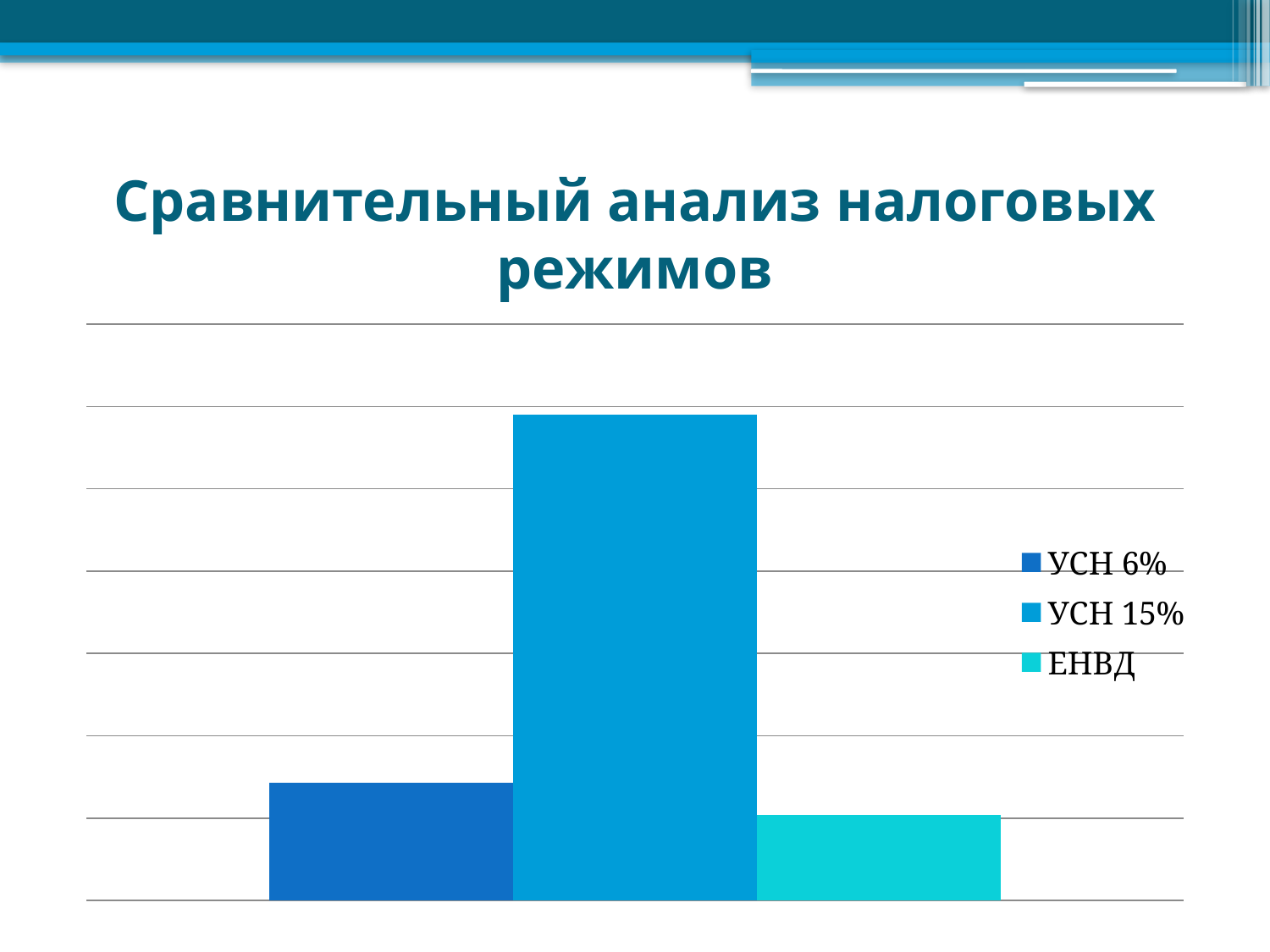
What kind of chart is shown on the slide? bar chart What are the three entries listed in the chart legend? УСН 6%, УСН 15%, ЕНВД How many series does the legend list? 3 Which is larger, the bar for УСН 6% or the bar for УСН 15%? УСН 15% Which is larger, the bar for УСН 6% or the bar for ЕНВД? УСН 6% How many bars are plotted in the chart? 3 Which is larger, the bar for ЕНВД or the bar for УСН 15%? УСН 15% Which series has the lowest bar? ЕНВД What is the title of the slide containing the chart? Сравнительный анализ налоговых режимов Which series has the highest bar? УСН 15%